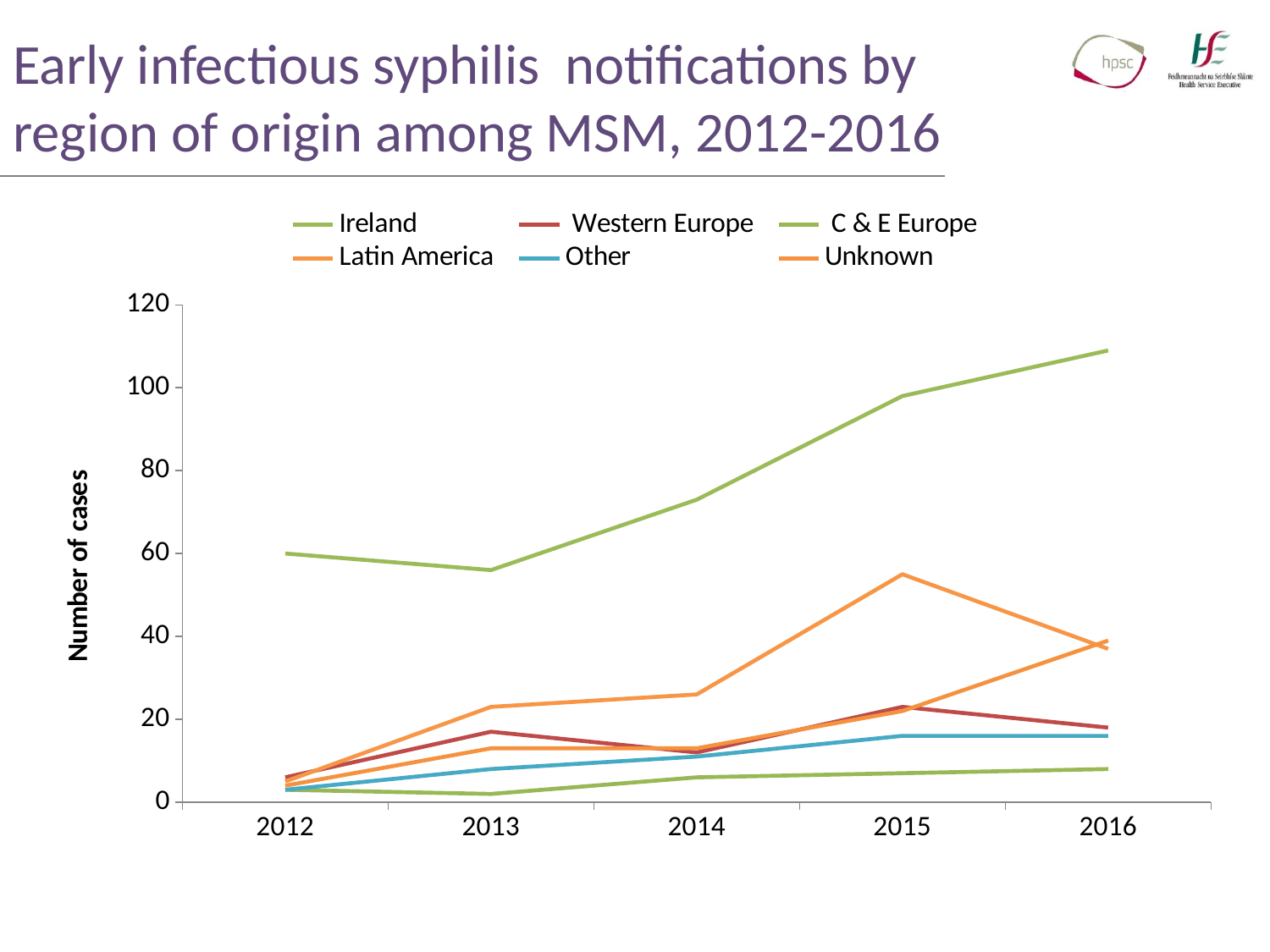
Is the value for Ireland in 2016 greater or less than 100? greater Which is larger in 2013, the value for Western Europe or the value for Other? Western Europe Is the value for C & E Europe in 2014 greater or less than 20? less Is the value for Ireland in 2015 greater or less than 80? greater Which region has the highest number of cases in 2016? Ireland What is the label on the y axis? Number of cases How many years are plotted along the x axis? 5 What kind of chart is shown on the slide? line chart Which region has the lowest number of cases in 2016? C & E Europe Does the Ireland line rise or fall from 2013 to 2016? rises How many series does the legend list? 6